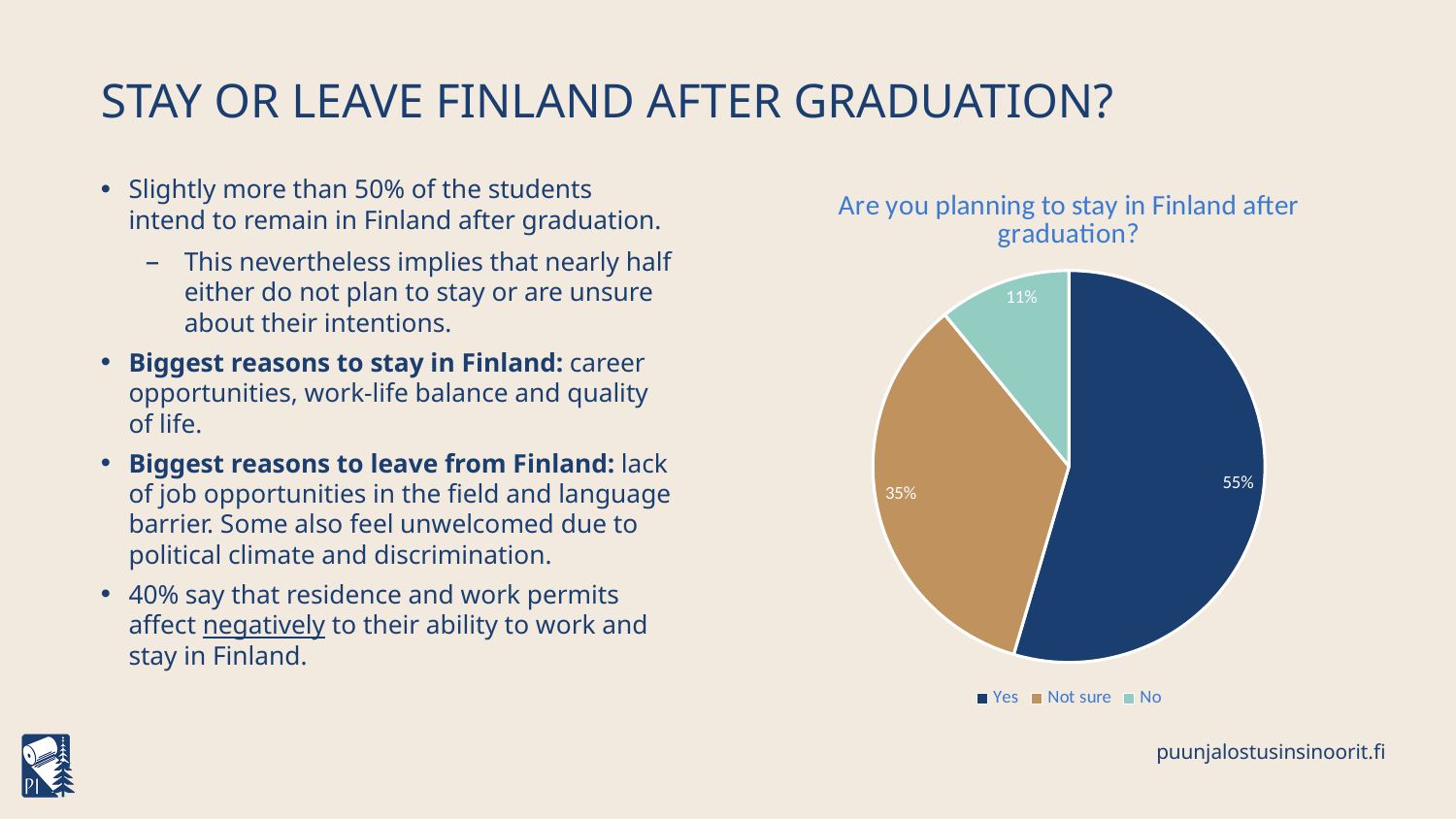
What is the title of the chart? Are you planning to stay in Finland after graduation? What type of chart is shown on the slide? Pie chart What percentage of respondents answered "Yes" to planning to stay in Finland after graduation? 55% What is the difference in percentage points between the "Not sure" and "No" slices? 24 What percentage of respondents answered "No"? 11% What percentage of respondents answered "Not sure"? 35% Which response has the largest share of the pie? Yes Which is larger, the "Not sure" slice or the "No" slice? Not sure How many entries does the legend list? 3 What is the difference in percentage points between the "Yes" and "Not sure" slices? 20 How many slices does the pie chart have? 3 Which response has the smallest share of the pie? No